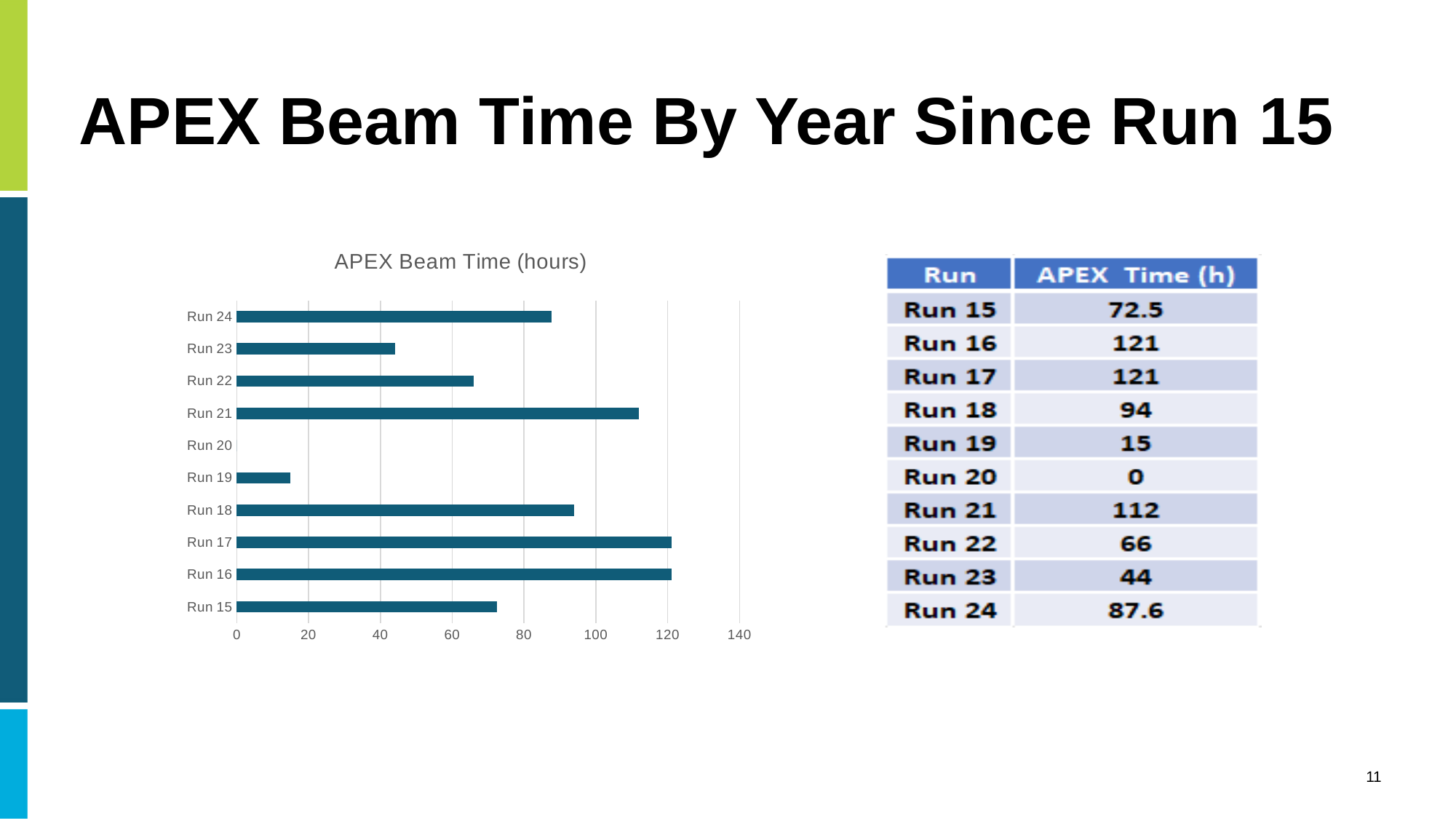
What is the difference in APEX beam time between Run 21 and Run 18? 18 How many runs are plotted in the chart? 10 What is the APEX beam time for Run 21? 112 What kind of chart is shown on the slide? bar chart What is the title of the chart? APEX Beam Time (hours) What is the APEX beam time for Run 24? 87.6 Is the value for Run 17 greater or less than 100? greater Which run has the lowest APEX beam time? Run 20 Which has more APEX beam time, Run 22 or Run 23? Run 22 Which run has the lowest non-zero APEX beam time? Run 19 Is the value for Run 23 greater or less than 60? less What is the APEX beam time for Run 15? 72.5